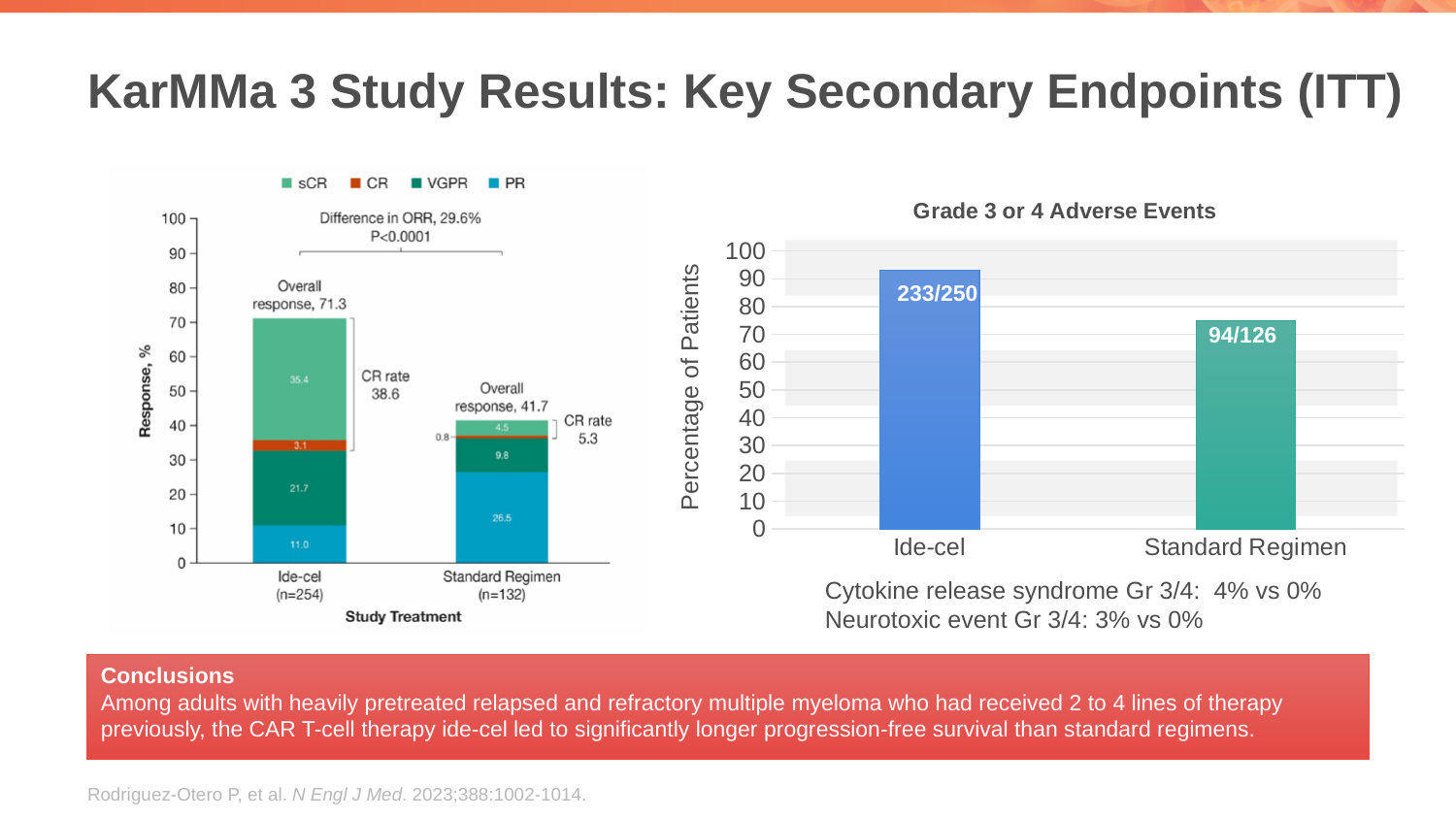
In the left response chart, what is the PR value for the Standard Regimen bar? 26.5 In the Grade 3 or 4 Adverse Events chart, what label is shown on the Standard Regimen bar? 94/126 In the Grade 3 or 4 Adverse Events chart, what label is shown on the Ide-cel bar? 233/250 In the Grade 3 or 4 Adverse Events chart, is the value for Ide-cel greater or less than 90? greater In the Grade 3 or 4 Adverse Events chart, how many treatment categories are shown? 2 In the left response chart, what is the difference between the CR rate for Ide-cel and the CR rate for Standard Regimen? 33.3 In the Grade 3 or 4 Adverse Events chart, is the value for Standard Regimen greater or less than 80? less In the Grade 3 or 4 Adverse Events chart, which treatment has the higher percentage of patients? Ide-cel In the left response chart, what is the difference in ORR stated above the bars? 29.6% What kind of chart is the Grade 3 or 4 Adverse Events chart? Bar chart In the left response chart, what is the overall response for Ide-cel? 71.3 How many series does the legend of the left response chart list? 4